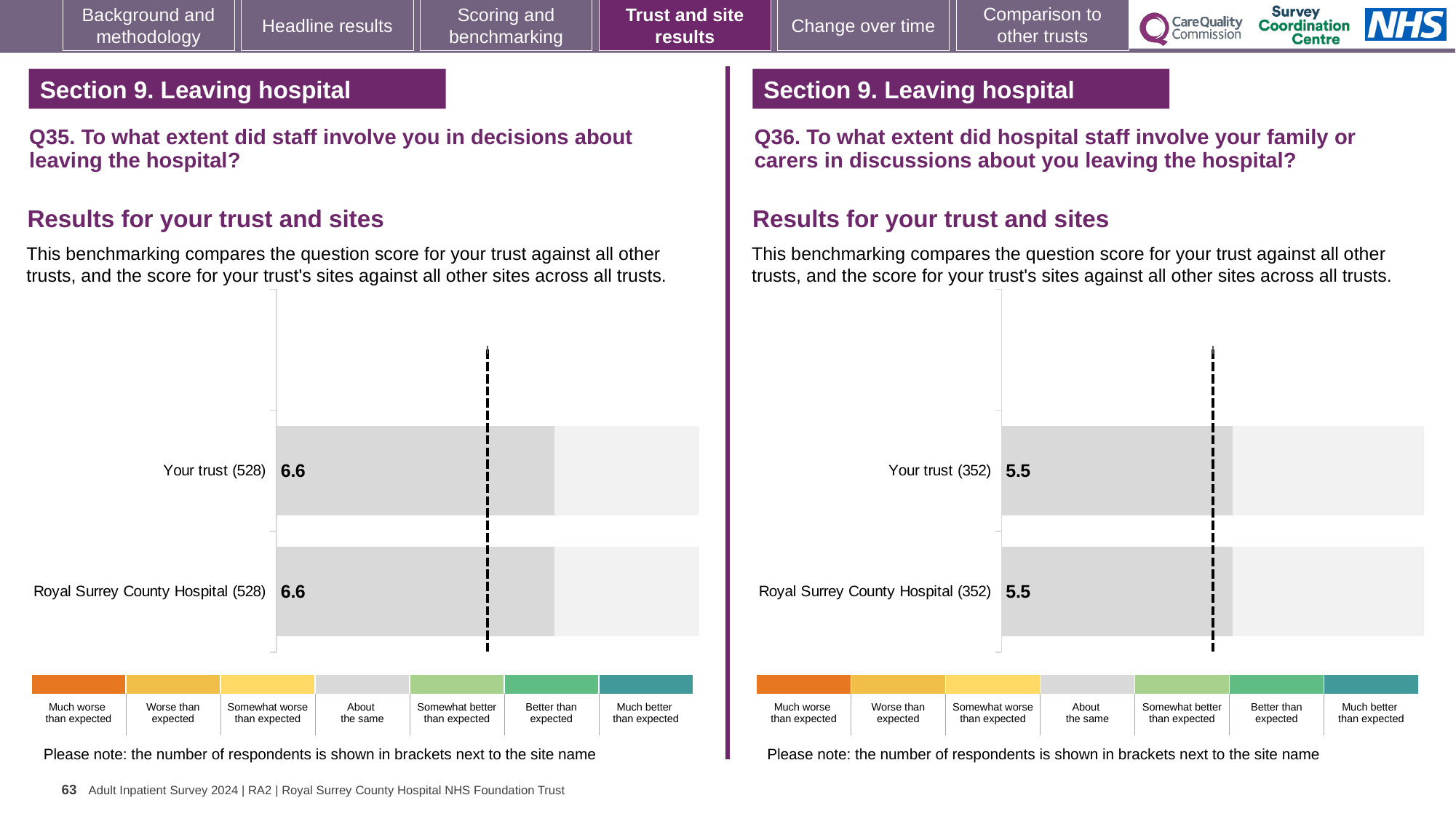
On the Q35 chart (left), what is the score for Royal Surrey County Hospital? 6.6 On the Q35 chart (left), what is the score for Your trust? 6.6 On the Q36 chart (right), how many bars are plotted? 2 On the Q35 chart (left), what is the difference between the score for Your trust and the score for Royal Surrey County Hospital? 0 What kind of chart is used on the Q35 chart (left)? Bar chart On the Q36 chart (right), what is the score for Royal Surrey County Hospital? 5.5 On the Q35 chart (left), how many respondents are shown in brackets for Your trust? 528 On the Q36 chart (right), what is the difference between the score for Your trust and the score for Royal Surrey County Hospital? 0 On the Q36 chart (right), how many respondents are shown in brackets for Royal Surrey County Hospital? 352 How many categories does the colour key below each chart list? 7 On the Q36 chart (right), what is the score for Your trust? 5.5 On the Q35 chart (left), how many bars are plotted? 2